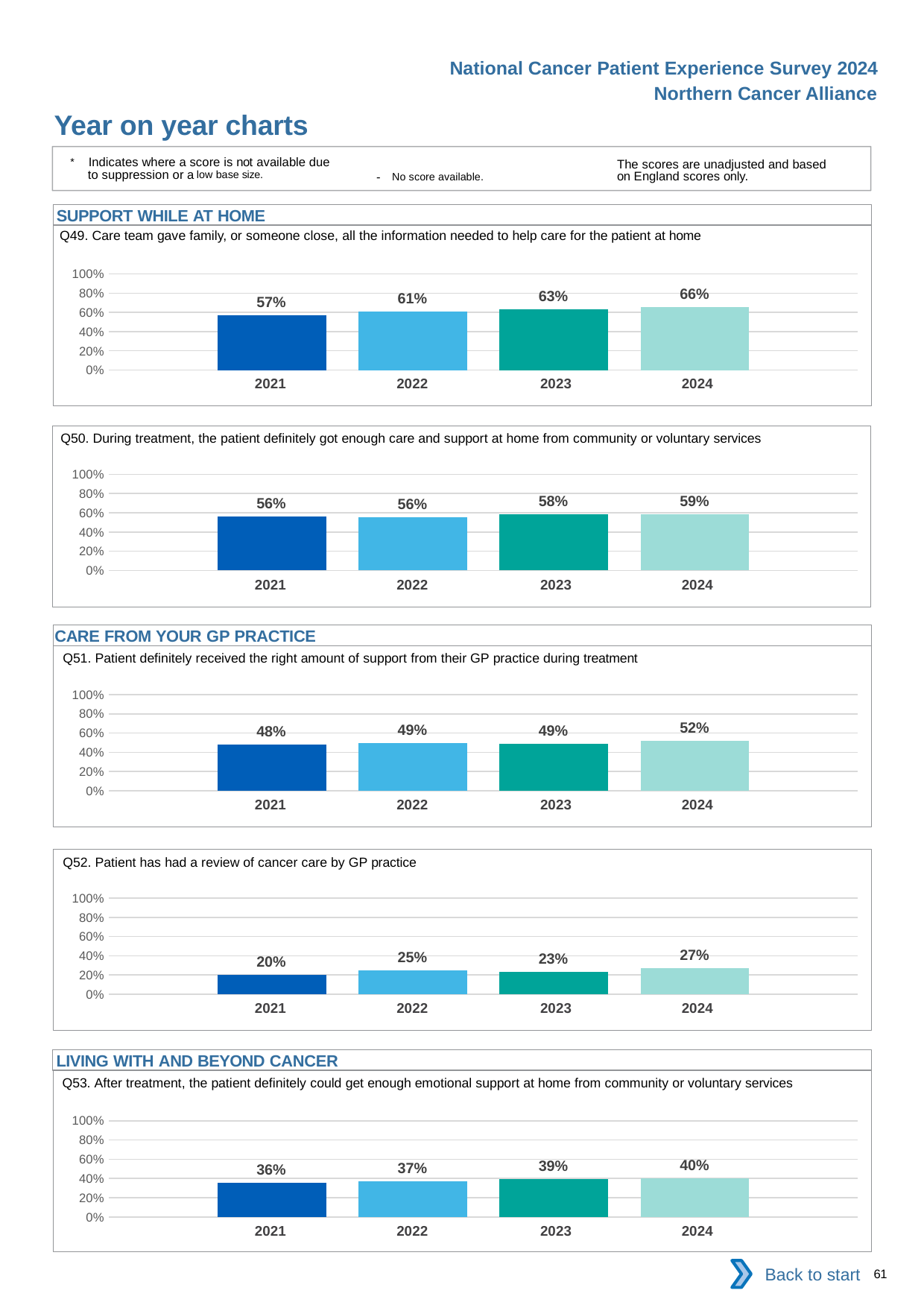
What kind of chart is the Q53 chart? bar chart In the Q49 chart, what is the value for 2024? 66% In the Q51 chart, which year has the highest value? 2024 In the Q52 chart, which year has the lowest value? 2021 How many years are shown in the Q51 chart? 4 In the Q52 chart, which is larger, the value for 2022 or the value for 2023? 2022 In the Q50 chart, what is the value for 2021? 56% In the Q49 chart, do the values rise or fall from 2021 to 2024? rise Which section heading appears above the Q53 chart? LIVING WITH AND BEYOND CANCER In the Q53 chart, is the value for 2024 greater or less than 60%? less In the Q52 chart, what is the difference between the 2024 and 2023 values? 4% In the Q49 chart, what is the difference between the 2024 and 2021 values? 9%